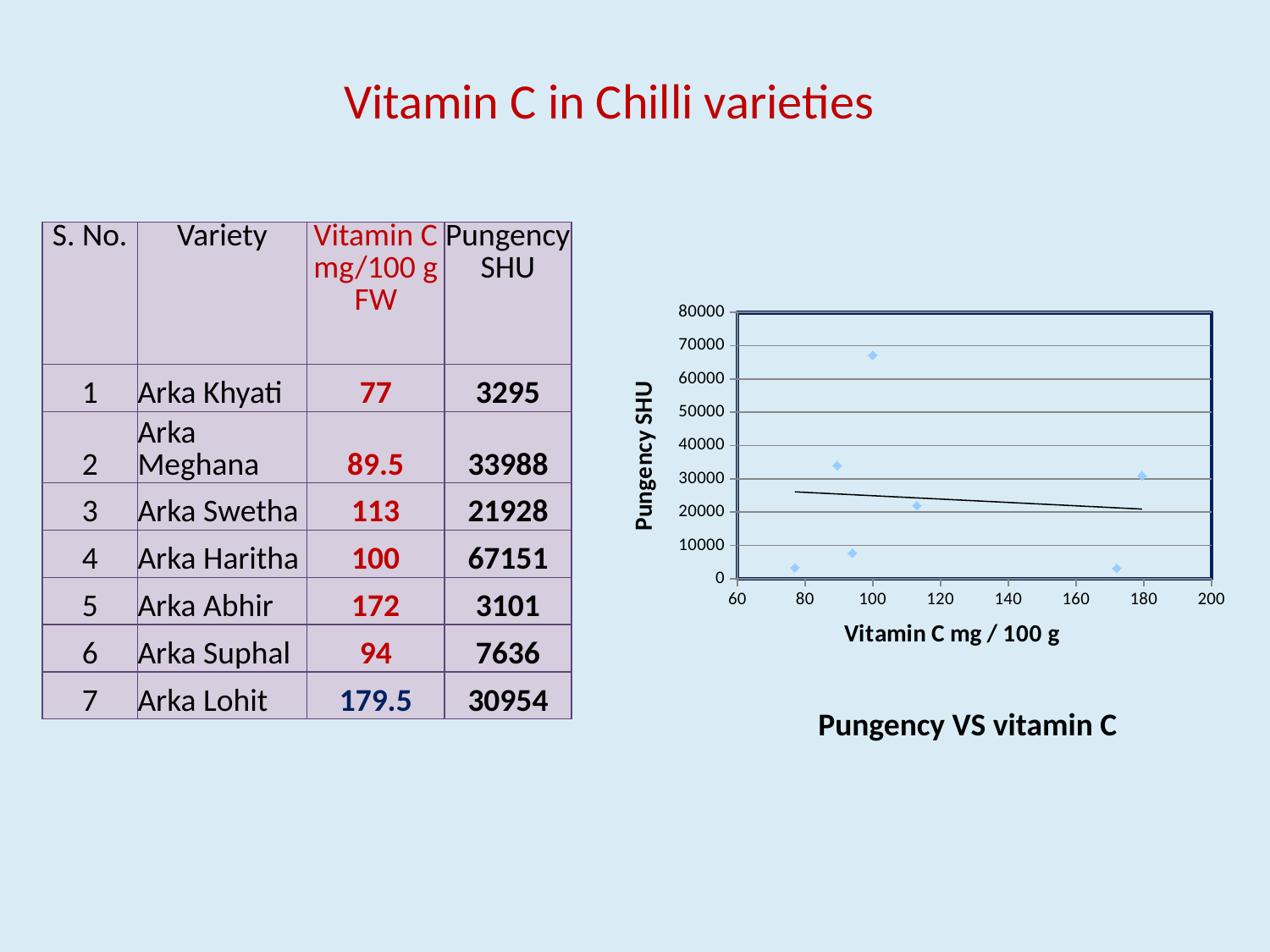
Is the pungency of the point plotted near 180 mg/100 g vitamin C greater or less than 40000? less What kind of chart is shown on the slide? scatter chart Is the highest plotted pungency value in the chart greater or less than 60000? greater Is the vitamin C value of the highest pungency point greater or less than 120? less Which is larger: the pungency of the point near 100 mg/100 g vitamin C or the point near 113 mg/100 g? the point near 100 mg/100 g Does the trend line in the Pungency VS vitamin C chart rise or fall as vitamin C increases? fall How many plotted points have a pungency below 10000 SHU? 3 How many data points are plotted in the Pungency VS vitamin C chart? 7 What is the label of the y axis of the chart? Pungency SHU What is the label of the x axis of the chart? Vitamin C mg / 100 g How many plotted points have a pungency above 40000 SHU? 1